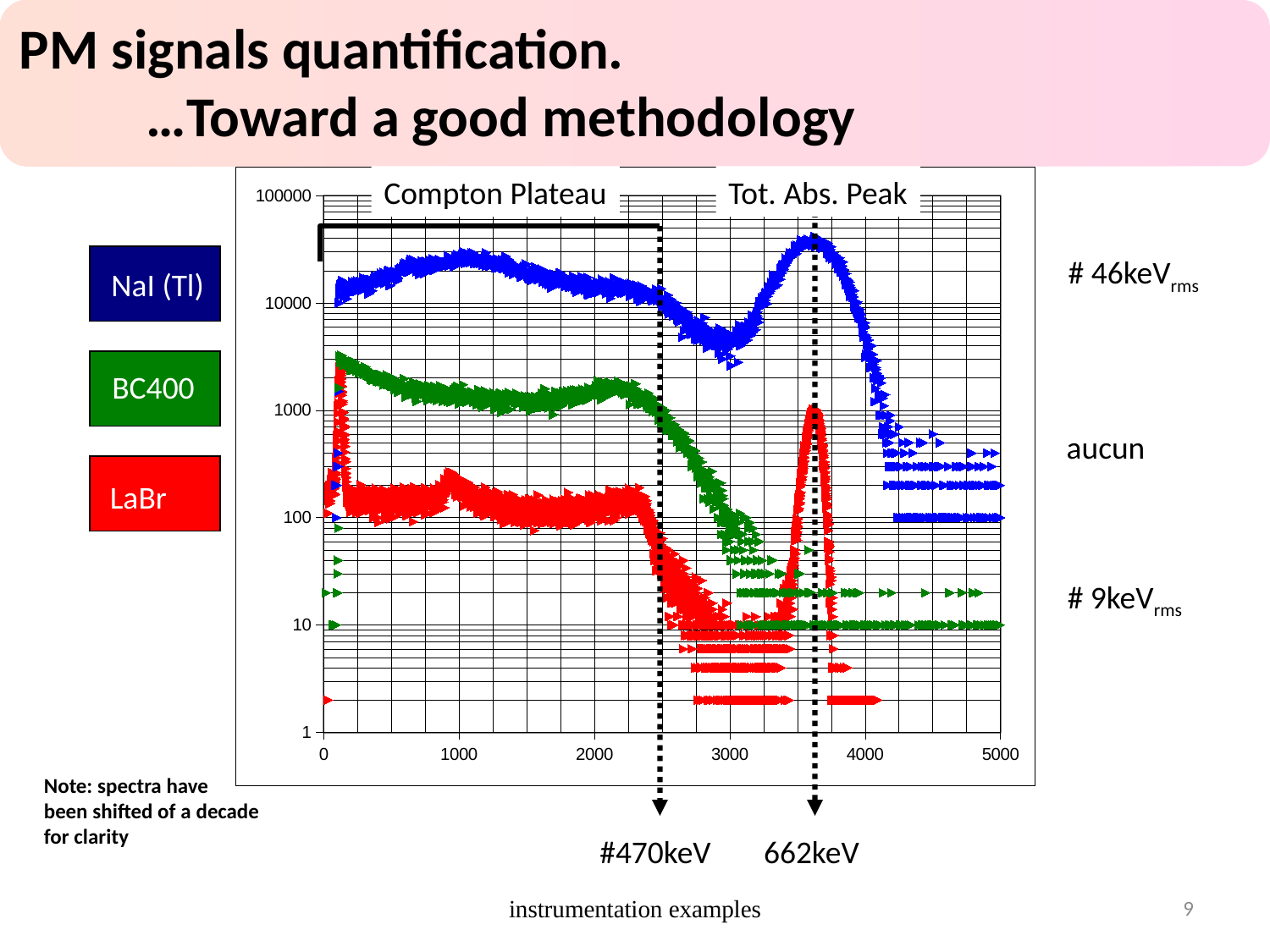
What colour is used for the LaBr series? red Is the value of the BC400 series at x = 1000 greater or less than 100? greater Is the value of the LaBr series at x = 1000 greater or less than 1000? less Which series has the lowest values in the Compton Plateau region? LaBr What is the maximum value shown on the x axis? 5000 How many data series (detector types) are plotted on the chart? 3 Which series has the highest values across the chart? NaI (Tl) Does the NaI (Tl) series rise or fall between x = 3000 and x = 3600? rise What energy label is placed under the dotted line marking the Tot. Abs. Peak? 662keV What kind of chart is shown on the slide? scatter chart Is the peak value of the NaI (Tl) series near x = 3600 greater or less than 10000? greater At x = 2000, which series has the larger value, NaI (Tl) or BC400? NaI (Tl)